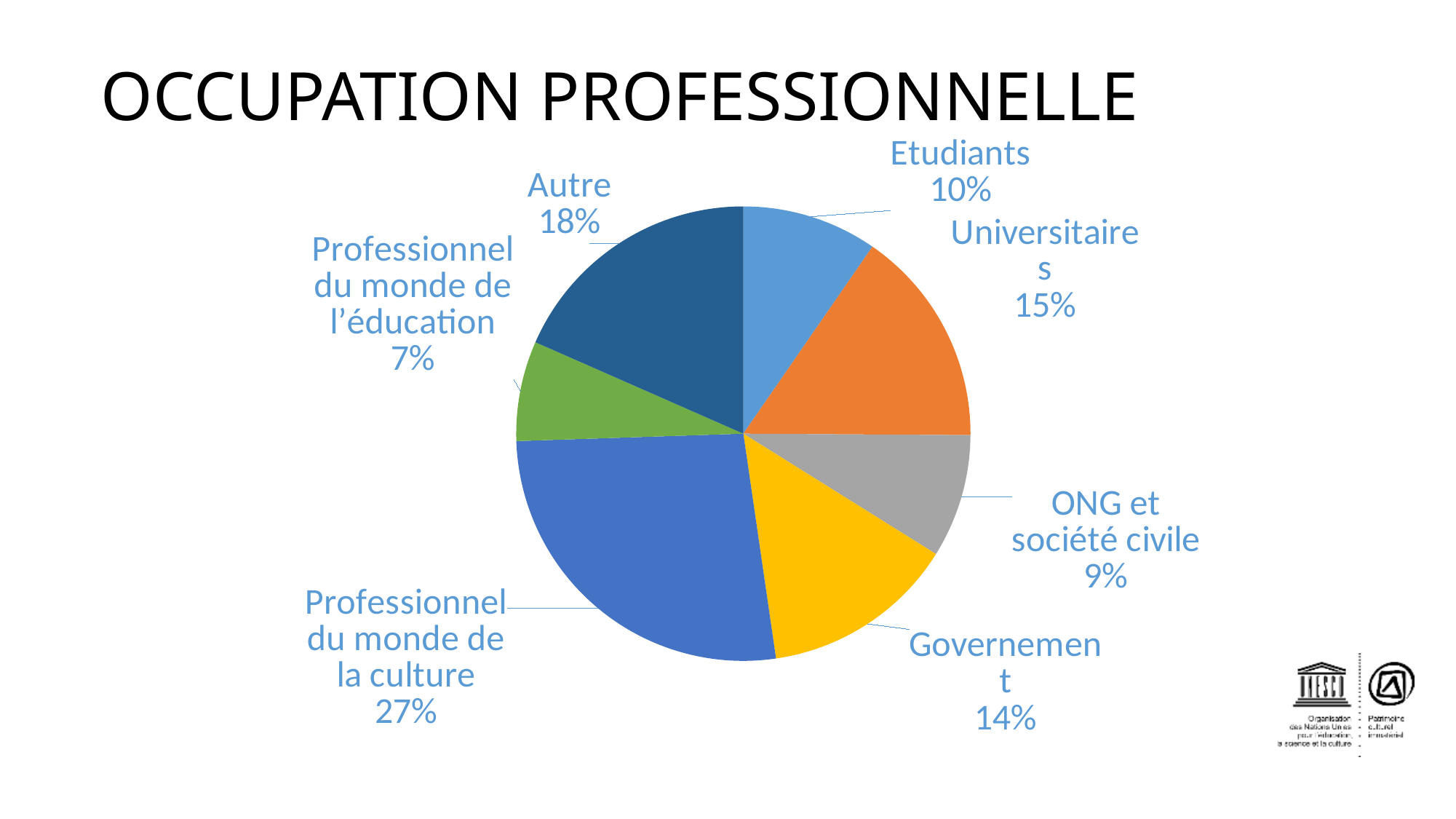
Which is larger, the share for Universitaires or the share for Governement? Universitaires What is the value for Universitaires? 15% What is the value for Governement? 14% How many categories does the pie chart have? 7 What is the title of the slide containing the chart? OCCUPATION PROFESSIONNELLE What share of the pie is Professionnel du monde de la culture? 27% Which category has the smallest share of the pie? Professionnel du monde de l'éducation What is the difference between the shares for Autre and Etudiants? 8% Which category has the largest share of the pie? Professionnel du monde de la culture What is the value for ONG et société civile? 9% What is the value for Etudiants? 10% What kind of chart is shown on the slide? pie chart